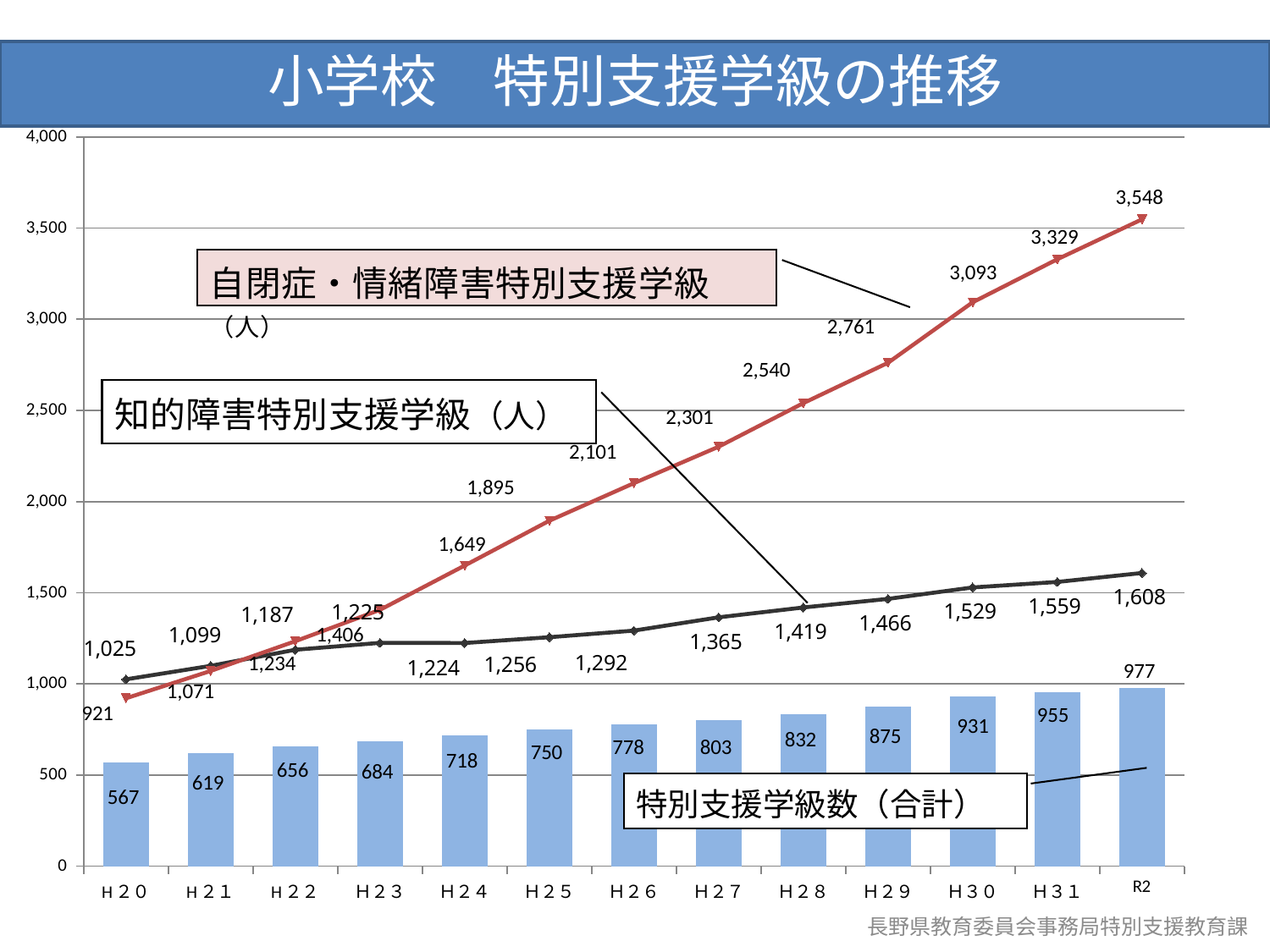
What is the value of 知的障害特別支援学級（人） for H24? 1,224 What is the title of the chart? 小学校 特別支援学級の推移 What is the difference between the 自閉症・情緒障害特別支援学級（人） values for R2 and H31? 219 Which year has the highest value for 自閉症・情緒障害特別支援学級（人）? R2 Which year has the lowest value for 特別支援学級数（合計）? H20 What is the value of 自閉症・情緒障害特別支援学級（人） for H27? 2,301 Which is larger in H20: 自閉症・情緒障害特別支援学級（人） or 知的障害特別支援学級（人）? 知的障害特別支援学級（人） How many years are shown on the x axis? 13 Does the value of 特別支援学級数（合計） rise or fall from H20 to R2? rise How many data series does the chart show? 3 What is the value of 特別支援学級数（合計） for R2? 977 What is the difference between the 特別支援学級数（合計） values for H30 and H29? 56